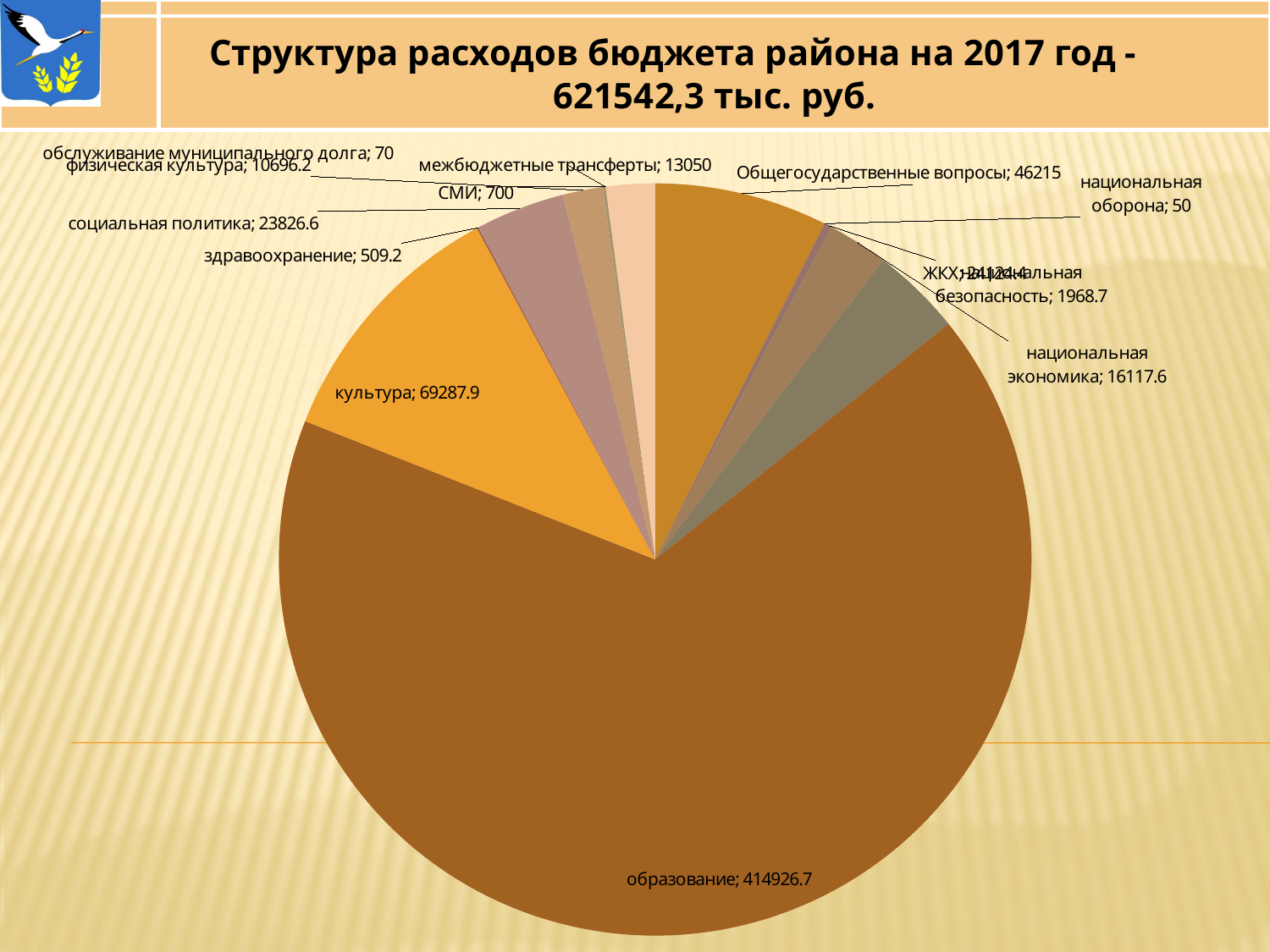
What is the value for культура? 69287.9 What is the value for образование? 414926.7 What is the value for национальная экономика? 16117.6 What is the value for социальная политика? 23826.6 What is the value for Общегосударственные вопросы? 46215 What kind of chart is shown on the slide? pie chart Which category has the smallest value? национальная оборона What total amount in тыс. руб. is stated in the chart title? 621542,3 тыс. руб. Which is larger, the value for физическая культура or the value for межбюджетные трансферты? межбюджетные трансферты What is the value for межбюджетные трансферты? 13050 What is the difference between the values for культура and социальная политика? 45461.3 Which category has the largest slice of the pie? образование